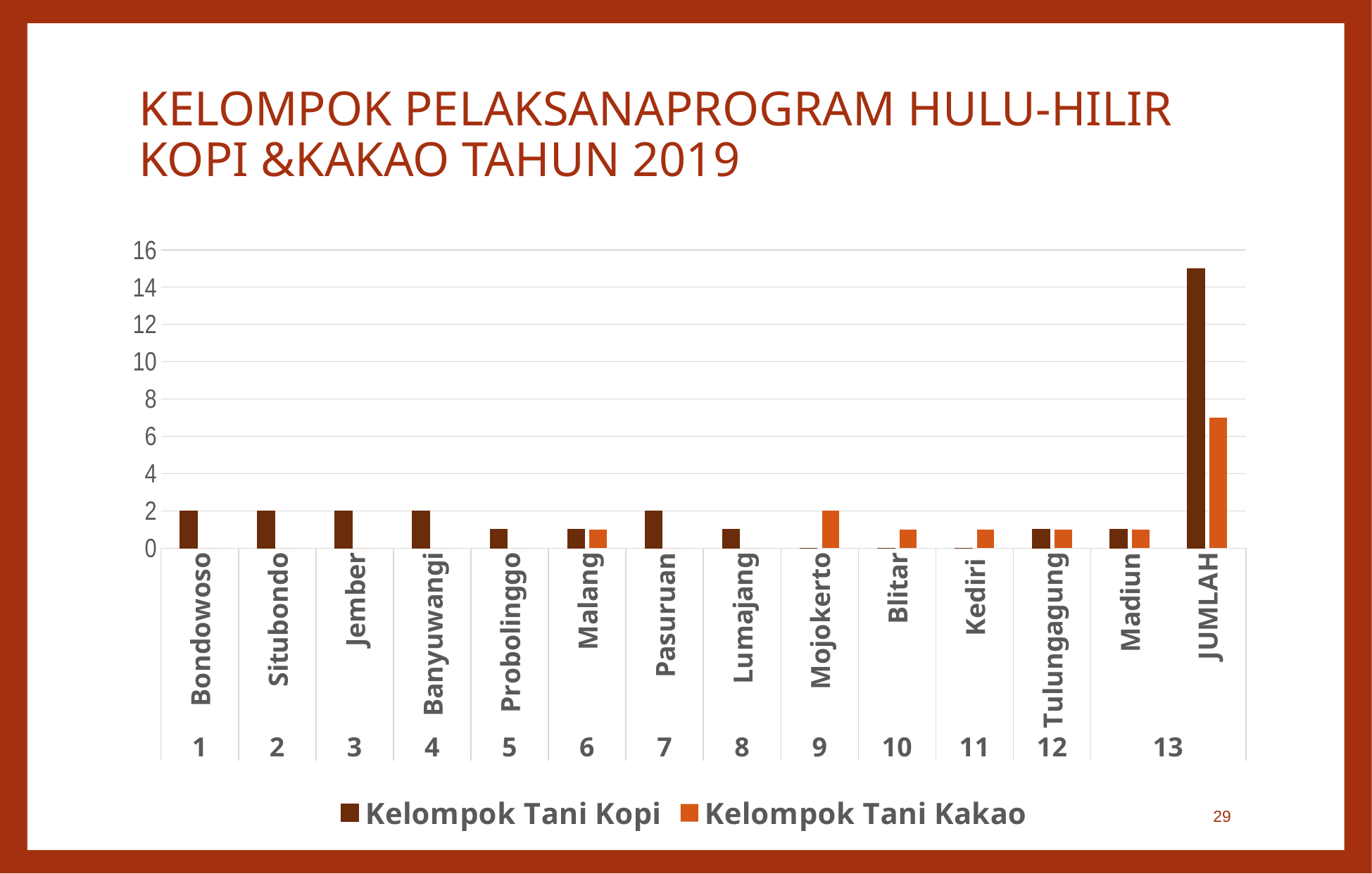
How many series does the legend list? 2 Which category has the highest Kelompok Tani Kakao value? JUMLAH For Mojokerto, which series has the larger value, Kelompok Tani Kopi or Kelompok Tani Kakao? Kelompok Tani Kakao For JUMLAH, which series has the larger value, Kelompok Tani Kopi or Kelompok Tani Kakao? Kelompok Tani Kopi What are the two series named in the legend? Kelompok Tani Kopi and Kelompok Tani Kakao What is the value of Kelompok Tani Kopi for Pasuruan? 2 What is the value of Kelompok Tani Kakao for Mojokerto? 2 Is the Kelompok Tani Kakao value for JUMLAH greater or less than 8? less What is the value of Kelompok Tani Kopi for Bondowoso? 2 What kind of chart is shown on the slide? bar chart Is the Kelompok Tani Kopi value for JUMLAH greater or less than 14? greater Which category has the highest Kelompok Tani Kopi value? JUMLAH